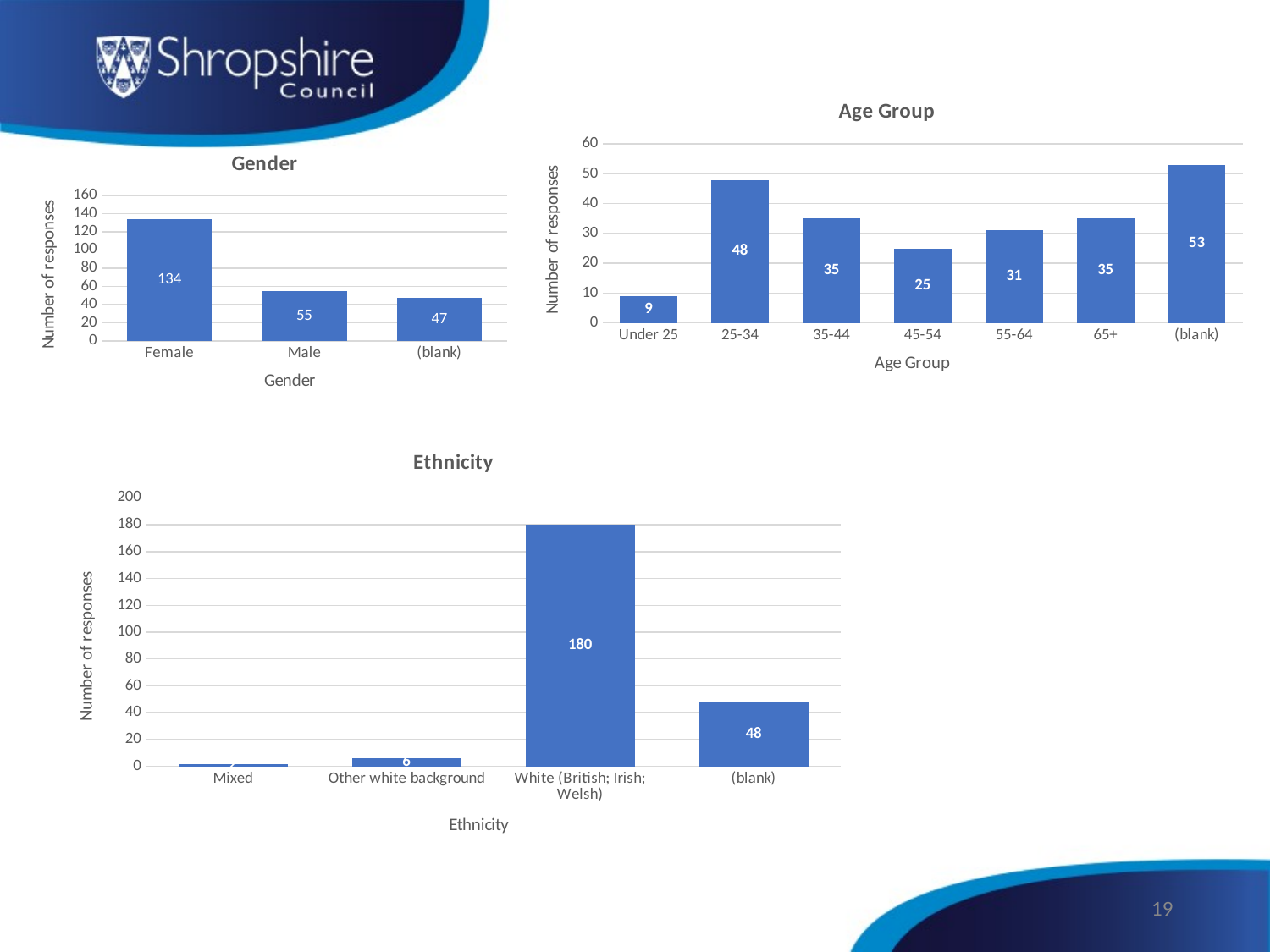
In the Age Group chart, which age group has the highest number of responses? (blank) In the Ethnicity chart, how many responses were from White (British; Irish; Welsh) respondents? 180 In the Age Group chart, what is the difference between the 25-34 and 45-54 response counts? 23 In the Gender chart, how many categories are shown on the x axis? 3 In the Age Group chart, how many responses were from the 25-34 age group? 48 In the Age Group chart, which age group has the lowest number of responses? Under 25 In the Gender chart, how many responses were from Female respondents? 134 In the Gender chart, what is the difference between the Female and Male response counts? 79 What kind of chart is the Ethnicity chart? Bar chart In the Ethnicity chart, is the value for Mixed greater or less than 20? less In the Age Group chart, which has more responses, 45-54 or 55-64? 55-64 In the Gender chart, which category has the lowest number of responses? (blank)